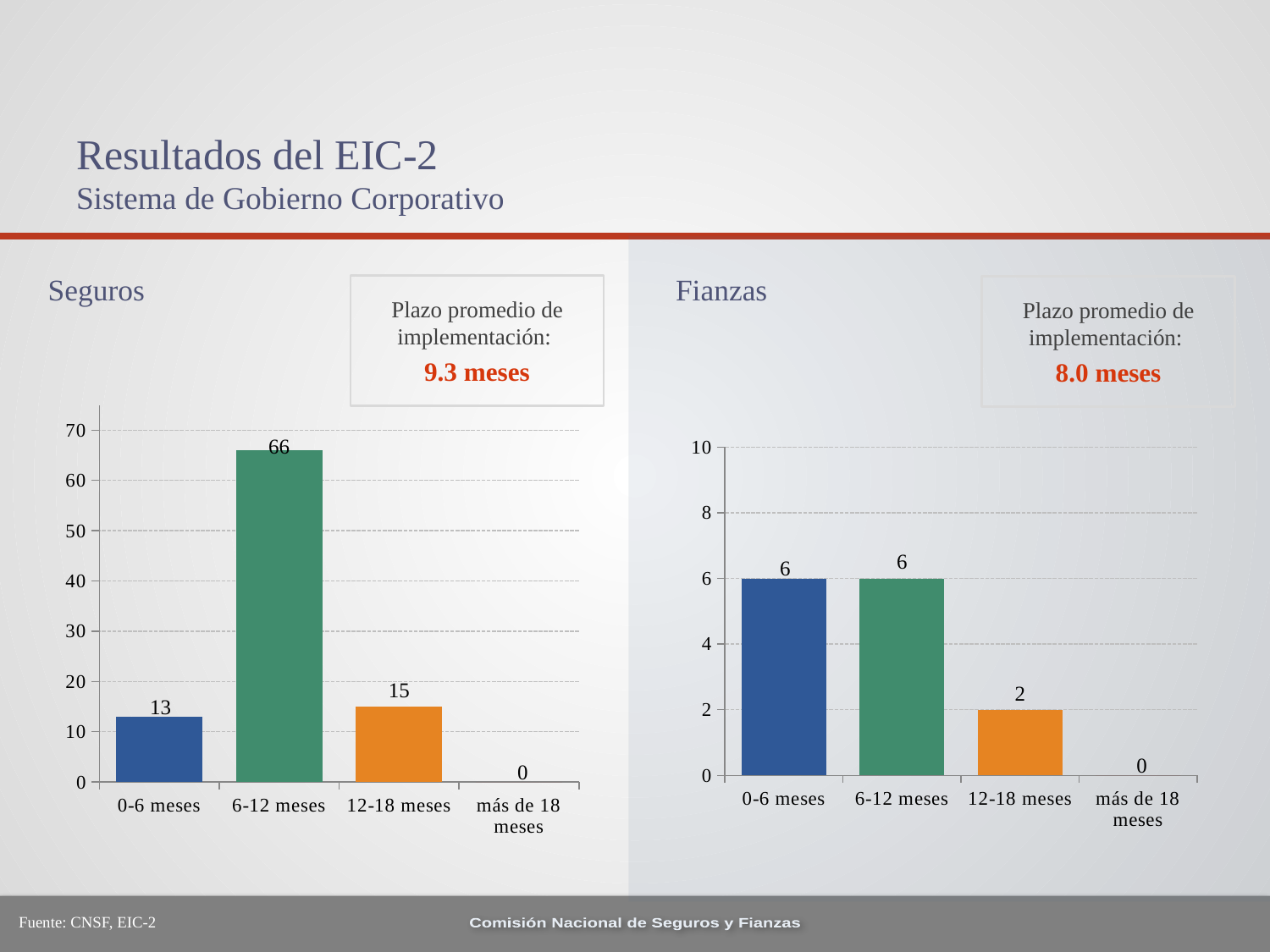
In the Seguros chart, what is the value for más de 18 meses? 0 In the Fianzas chart, which category has the lowest value? más de 18 meses In the Seguros chart, is the value for 6-12 meses greater or less than 60? greater In the Seguros chart, which category has the highest value? 6-12 meses How many categories are shown in the Fianzas chart? 4 What kind of chart is the Seguros chart? bar chart In the Seguros chart, what is the difference between the values for 6-12 meses and 12-18 meses? 51 What is the average implementation period (plazo promedio de implementación) shown for Fianzas? 8.0 meses In the Seguros chart, which is larger, the value for 0-6 meses or the value for 12-18 meses? 12-18 meses In the Seguros chart, what is the value for 6-12 meses? 66 In the Fianzas chart, what is the value for 12-18 meses? 2 In the Fianzas chart, what is the difference between the values for 0-6 meses and 12-18 meses? 4